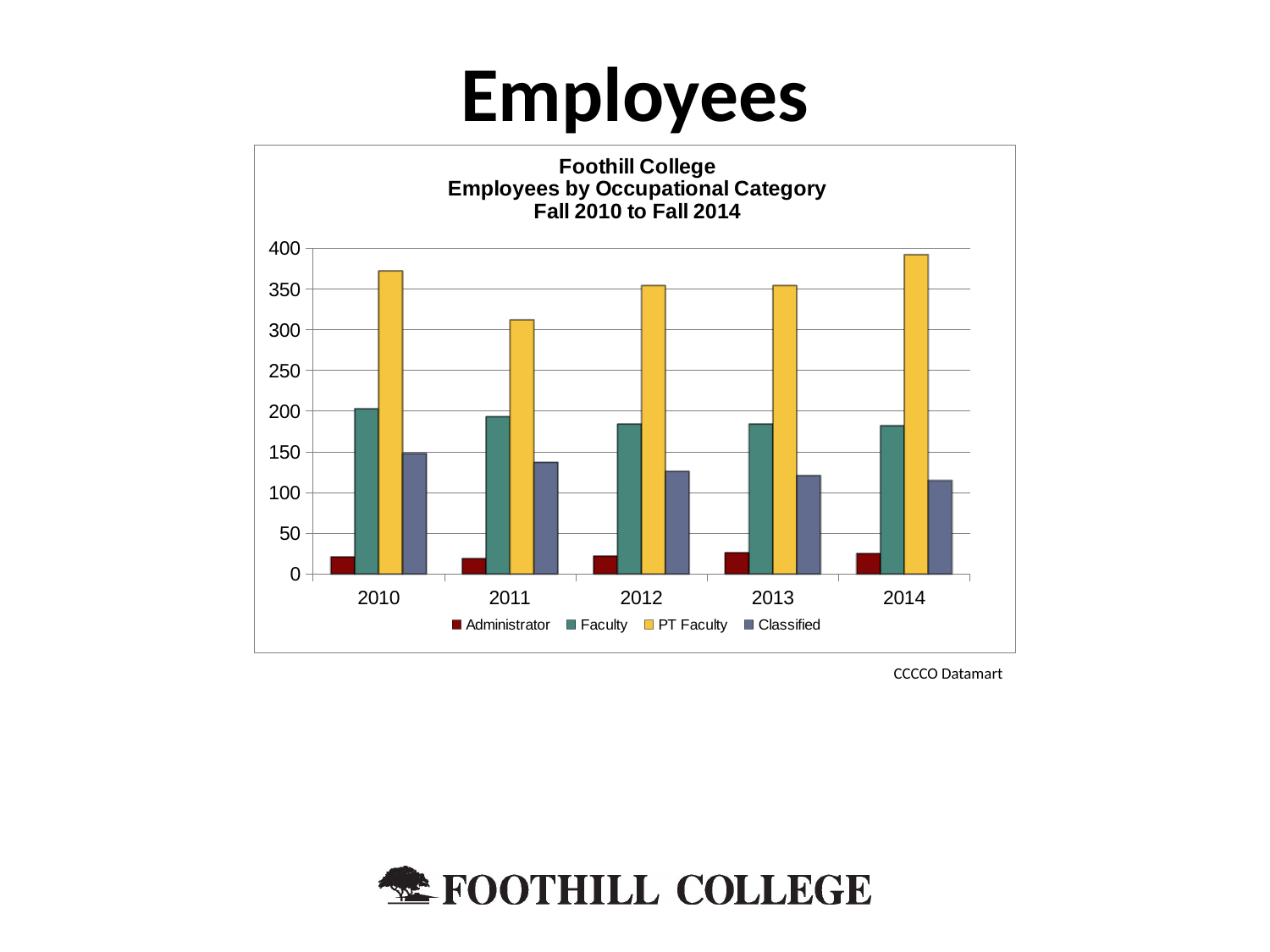
How many series does the legend list? 4 Is the value for Administrator in 2010 greater or less than 50? less How many years are shown on the x axis? 5 Is the value for PT Faculty in 2011 greater or less than 300? greater In 2013, which is larger, Faculty or Classified? Faculty Is the value for Classified in 2014 greater or less than 100? greater Do the Classified values rise or fall from 2010 to 2014? fall In which year is the PT Faculty bar the highest? 2014 In which year is the PT Faculty bar the lowest? 2011 Which occupational category has the tallest bar in 2010? PT Faculty What kind of chart is shown on the slide? bar chart